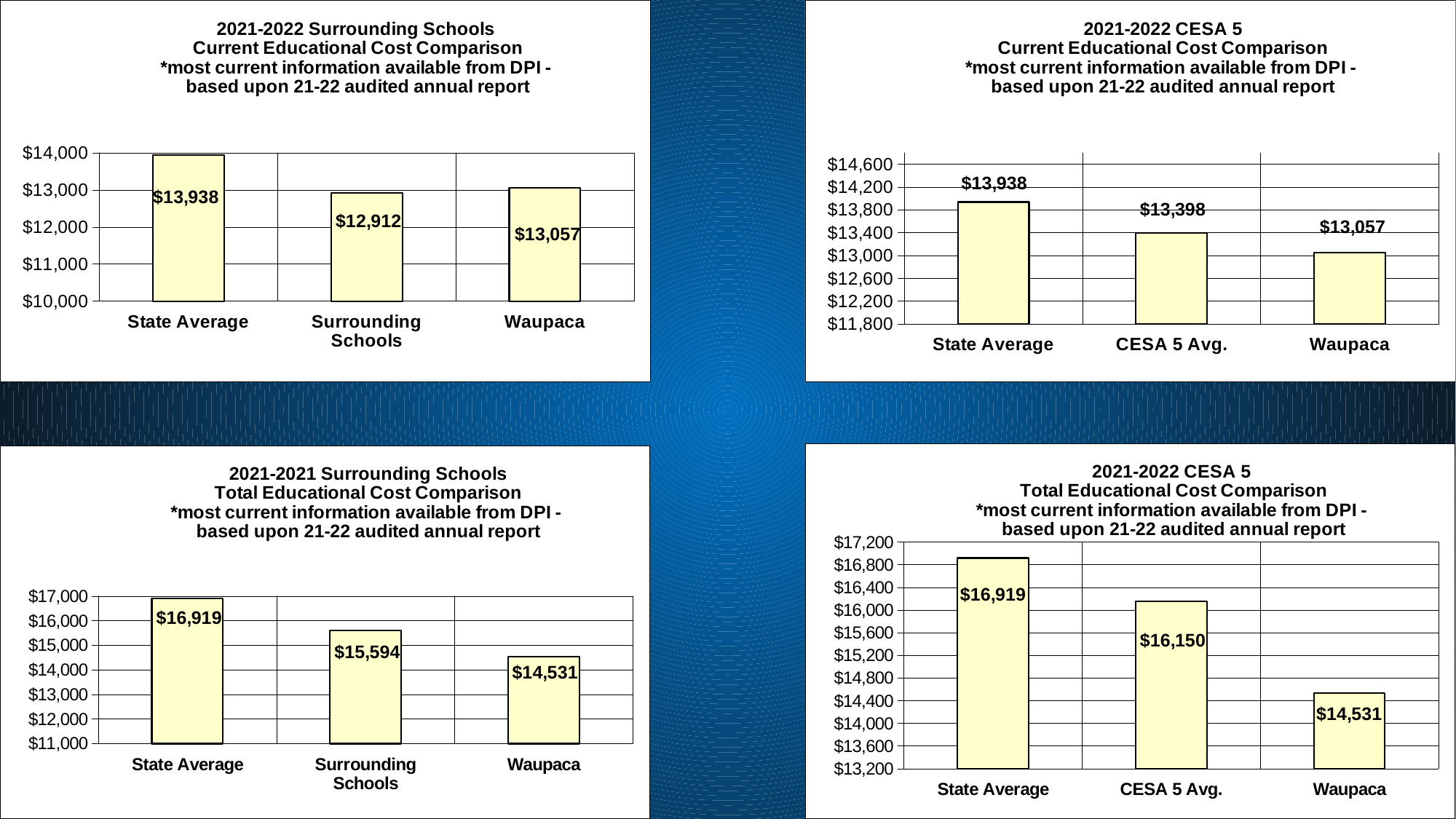
In the bottom-right chart (2021-2022 CESA 5 Total Educational Cost Comparison), what is the value for CESA 5 Avg.? $16,150 In the bottom-right chart (2021-2022 CESA 5 Total Educational Cost Comparison), what is the difference between State Average and CESA 5 Avg.? $769 In the bottom-right chart (2021-2022 CESA 5 Total Educational Cost Comparison), do the values rise or fall from left to right? fall In the top-right chart (2021-2022 CESA 5 Current Educational Cost Comparison), what is the value for CESA 5 Avg.? $13,398 In the top-right chart (2021-2022 CESA 5 Current Educational Cost Comparison), what is the difference between State Average and Waupaca? $881 In the top-right chart (2021-2022 CESA 5 Current Educational Cost Comparison), which category has the highest value? State Average In the top-left chart (2021-2022 Surrounding Schools Current Educational Cost Comparison), which category has the lowest value? Surrounding Schools In the bottom-left chart (2021-2021 Surrounding Schools Total Educational Cost Comparison), what is the value for Waupaca? $14,531 What kind of chart is the bottom-left chart (2021-2021 Surrounding Schools Total Educational Cost Comparison)? bar chart How many categories are shown in the top-left chart (2021-2022 Surrounding Schools Current Educational Cost Comparison)? 3 In the bottom-left chart (2021-2021 Surrounding Schools Total Educational Cost Comparison), which is larger, Surrounding Schools or Waupaca? Surrounding Schools In the top-left chart (2021-2022 Surrounding Schools Current Educational Cost Comparison), what is the value for Surrounding Schools? $12,912